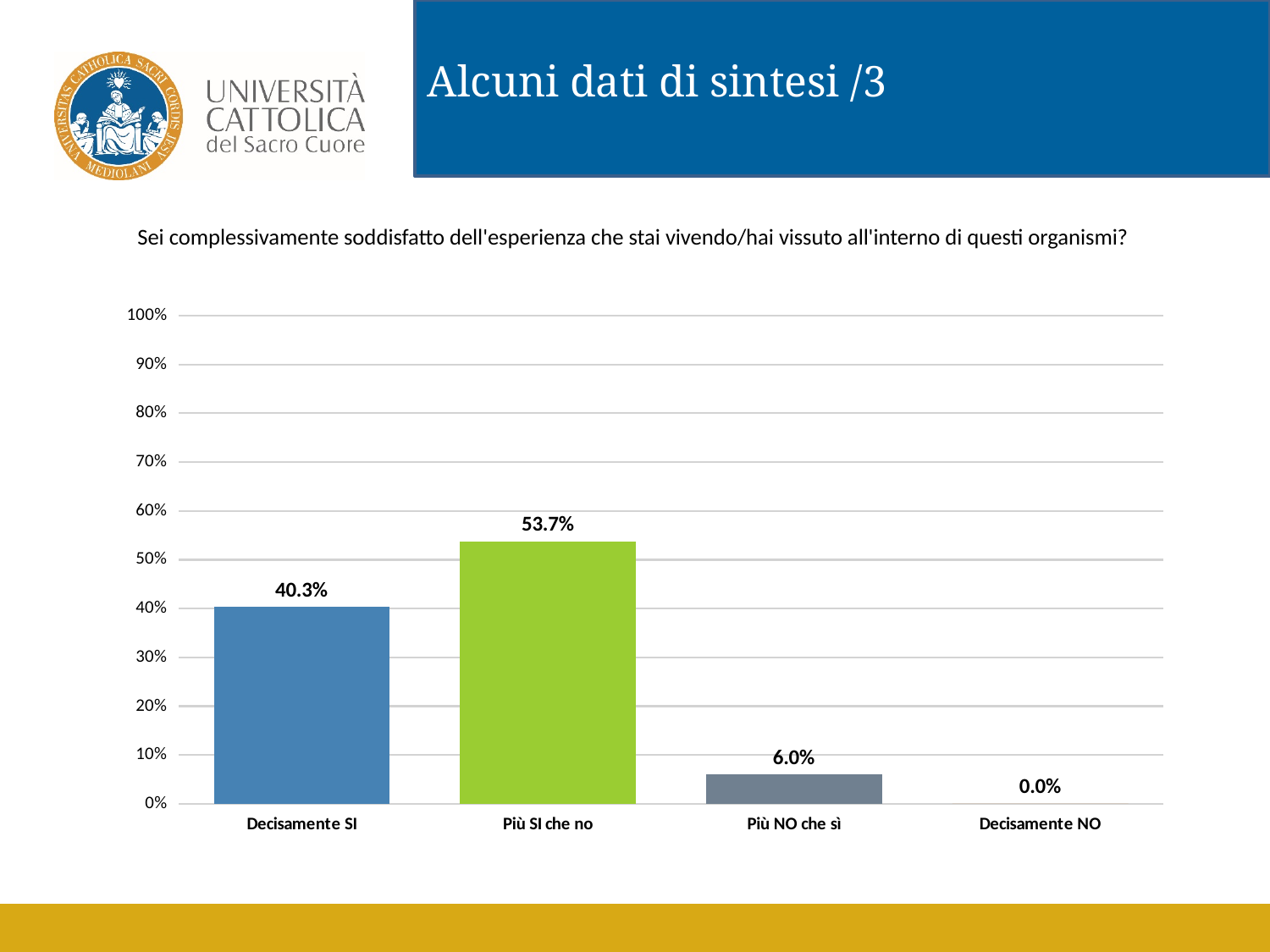
What is the question text shown above the chart? Sei complessivamente soddisfatto dell'esperienza che stai vivendo/hai vissuto all'interno di questi organismi? Which category has the lowest value? Decisamente NO Which category has the highest value? Più SI che no What is the difference between the values for "Più SI che no" and "Decisamente SI"? 13.4% What is the value for "Decisamente SI"? 40.3% What is the value for "Più NO che sì"? 6.0% What kind of chart is shown on the slide? bar chart What is the value for "Decisamente NO"? 0.0% What is the value for "Più SI che no"? 53.7% How many categories are shown on the x axis? 4 Which is larger, the value for "Decisamente SI" or the value for "Più NO che sì"? Decisamente SI Is the value for "Più SI che no" greater or less than 50%? greater